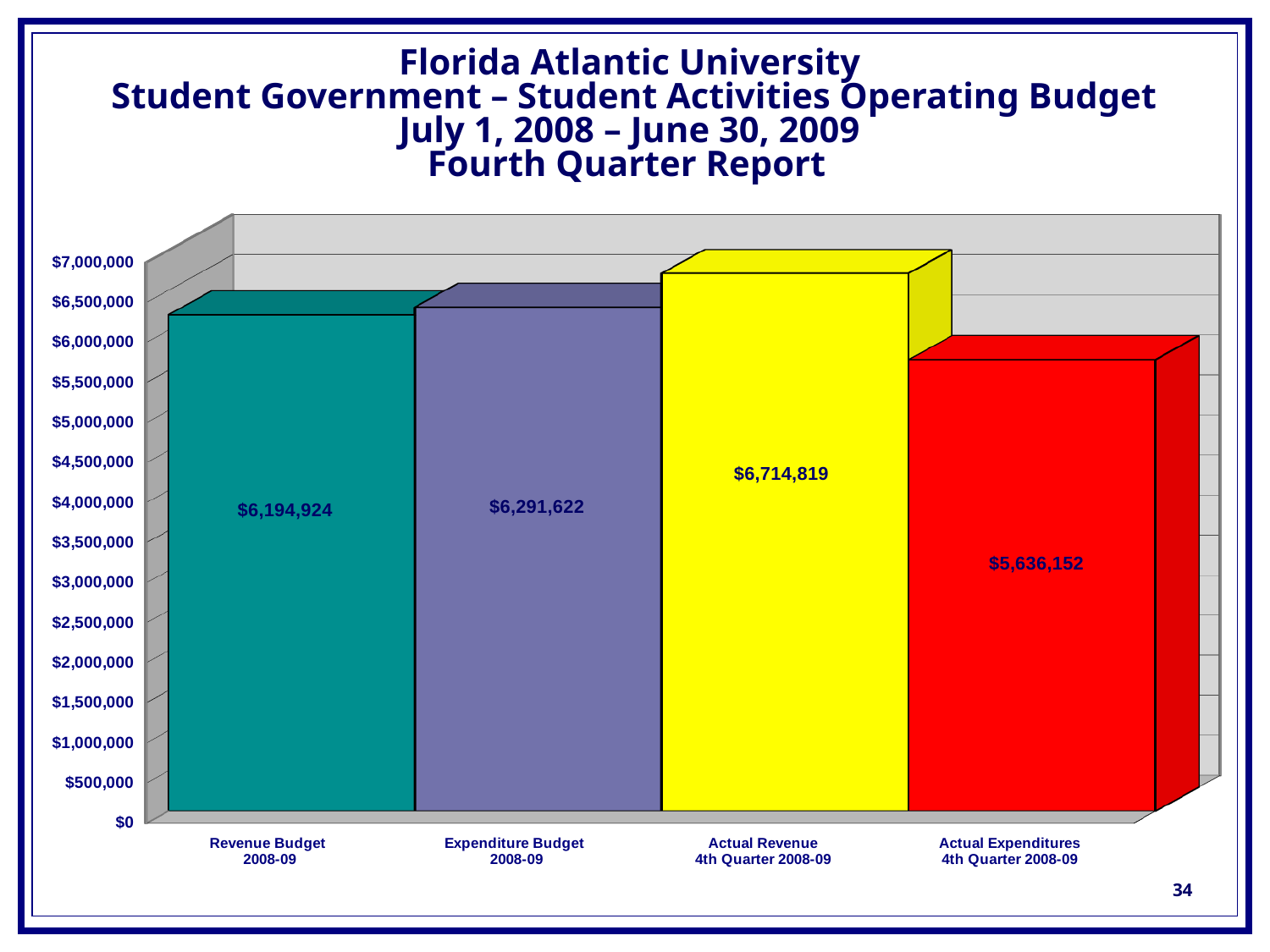
What colour is the bar for Actual Revenue 4th Quarter 2008-09? yellow What is the difference between Expenditure Budget 2008-09 and Revenue Budget 2008-09? $96,698 What is the difference between Actual Revenue 4th Quarter 2008-09 and Actual Expenditures 4th Quarter 2008-09? $1,078,667 Which category has the highest value? Actual Revenue 4th Quarter 2008-09 Is the value for Actual Expenditures 4th Quarter 2008-09 greater or less than $6,000,000? less What is the value for Actual Expenditures 4th Quarter 2008-09? $5,636,152 How many bars are shown in the chart? 4 Which category has the lowest value? Actual Expenditures 4th Quarter 2008-09 What kind of chart is shown on the slide? bar chart What is the value for Actual Revenue 4th Quarter 2008-09? $6,714,819 Which is larger, Revenue Budget 2008-09 or Expenditure Budget 2008-09? Expenditure Budget 2008-09 What is the value for Revenue Budget 2008-09? $6,194,924